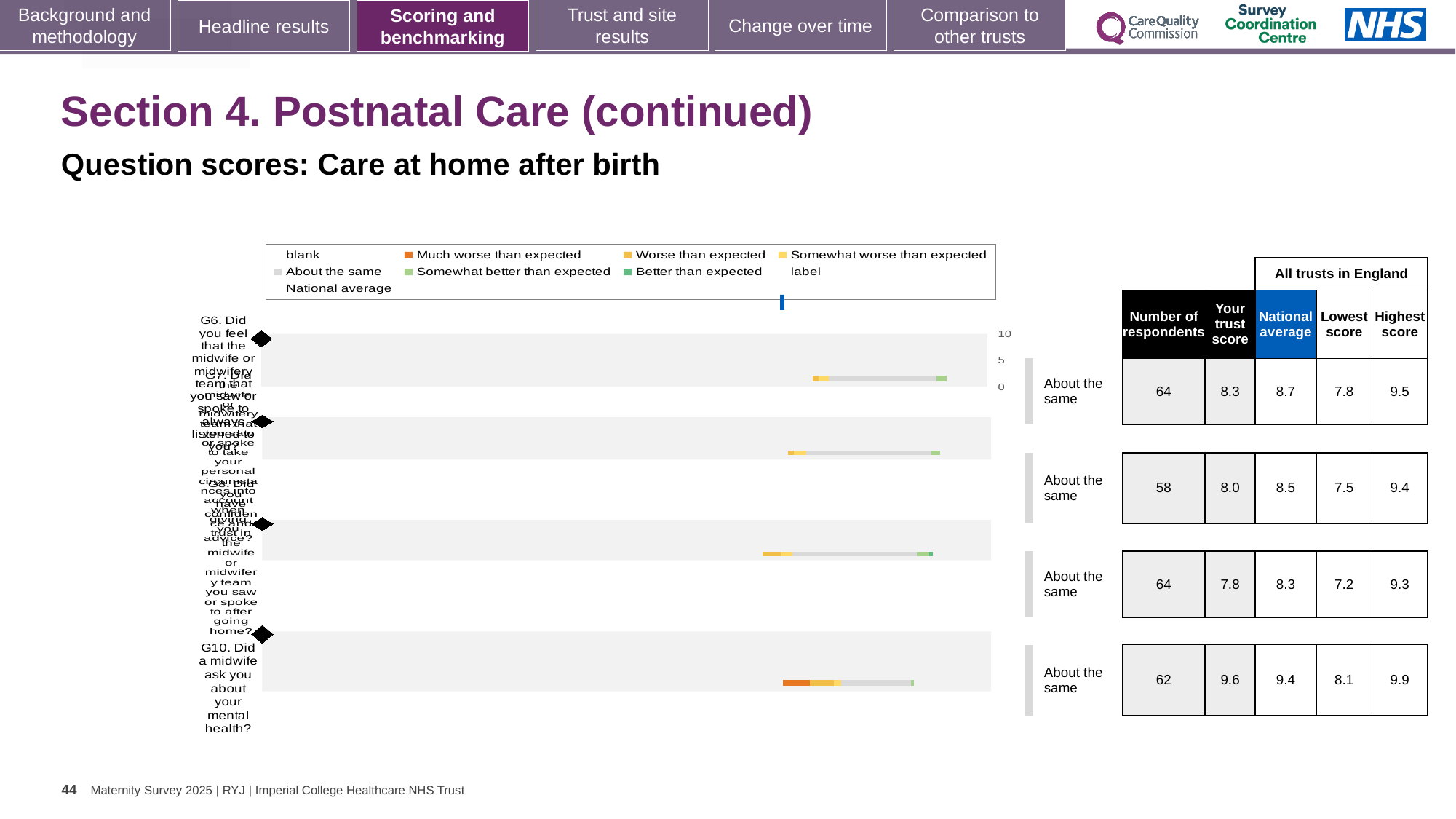
For question G10, what is the difference between the highest score and the lowest score across all trusts in England? 1.8 For question G10, is the trust score or the national average larger? trust score How many respondents are listed for question G10? 62 What benchmark category is shown for question G10? About the same What kind of chart is shown on the slide? bar chart Which question row has the highest trust score? G10 What is the national average for question G10? 9.4 How many questions (rows) are plotted in the chart? 4 What is the lowest trust score shown in the table? 7.8 What is the highest score across all trusts in England for question G10? 9.9 What is the trust score for the first row, question G6? 8.3 What is the trust score for question G10 (Did a midwife ask you about your mental health?)? 9.6